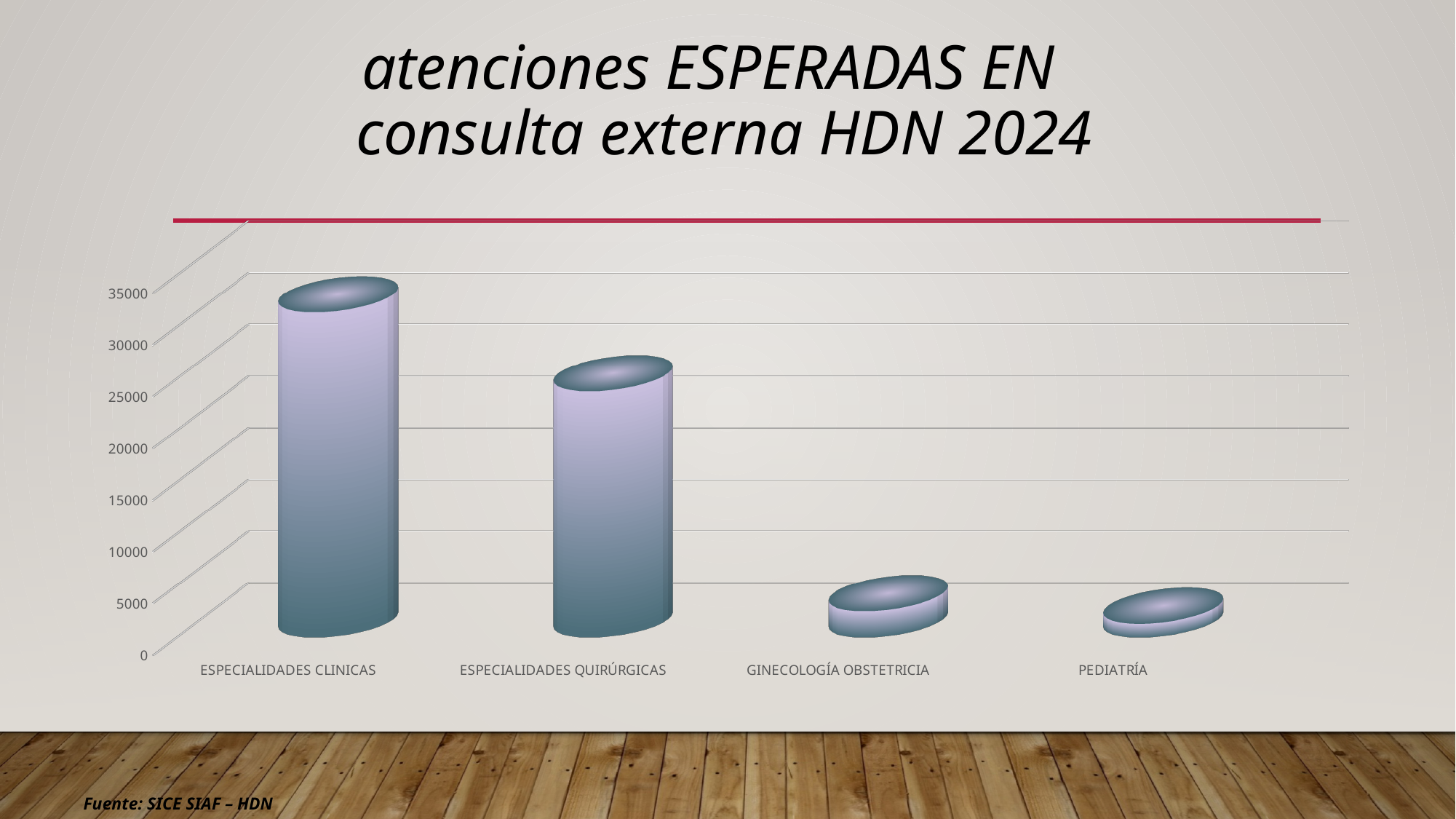
Which category has the highest value in the chart? ESPECIALIDADES CLINICAS What is the title of the slide containing the chart? atenciones ESPERADAS EN consulta externa HDN 2024 Which is larger, the value for ESPECIALIDADES QUIRÚRGICAS or the value for GINECOLOGÍA OBSTETRICIA? ESPECIALIDADES QUIRÚRGICAS Is the value for ESPECIALIDADES CLINICAS greater or less than 30000? greater What kind of chart is shown on the slide? bar chart Which is larger, the value for ESPECIALIDADES CLINICAS or the value for ESPECIALIDADES QUIRÚRGICAS? ESPECIALIDADES CLINICAS Is the value for PEDIATRÍA greater or less than 5000? less Is the value for ESPECIALIDADES QUIRÚRGICAS greater or less than 20000? greater Do the values rise or fall from left to right along the x axis? fall How many categories are shown on the x axis of the chart? 4